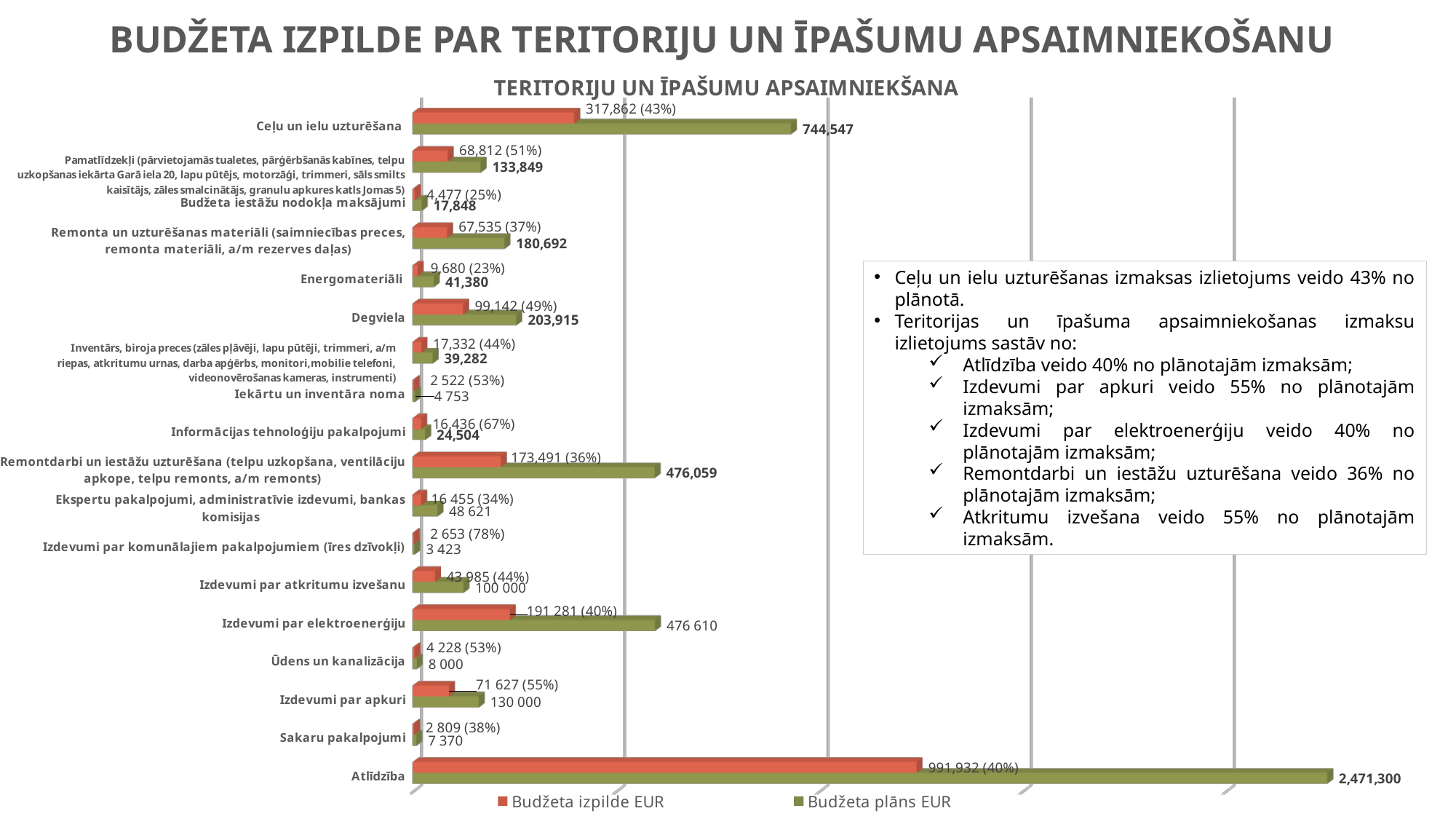
What is the Budžeta plāns EUR value for Atlīdzība? 2,471,300 Which category has the lowest Budžeta plāns EUR value? Izdevumi par komunālajiem pakalpojumiem (īres dzīvokļi) How many series does the legend list? 2 What kind of chart is shown on the slide? bar chart What is the difference between the Budžeta plāns EUR and Budžeta izpilde EUR values for Ceļu un ielu uzturēšana? 426,685 What are the two series named in the legend? Budžeta izpilde EUR and Budžeta plāns EUR What is the title of the chart? TERITORIJU UN ĪPAŠUMU APSAIMNIEKŠANA Which category has the highest Budžeta plāns EUR value? Atlīdzība What is the Budžeta plāns EUR value for Izdevumi par atkritumu izvešanu? 100 000 Which has the larger Budžeta plāns EUR value, Degviela or Remonta un uzturēšanas materiāli? Degviela What is the Budžeta plāns EUR value for Ceļu un ielu uzturēšana? 744,547 What is the Budžeta izpilde EUR value for Degviela? 99,142 (49%)